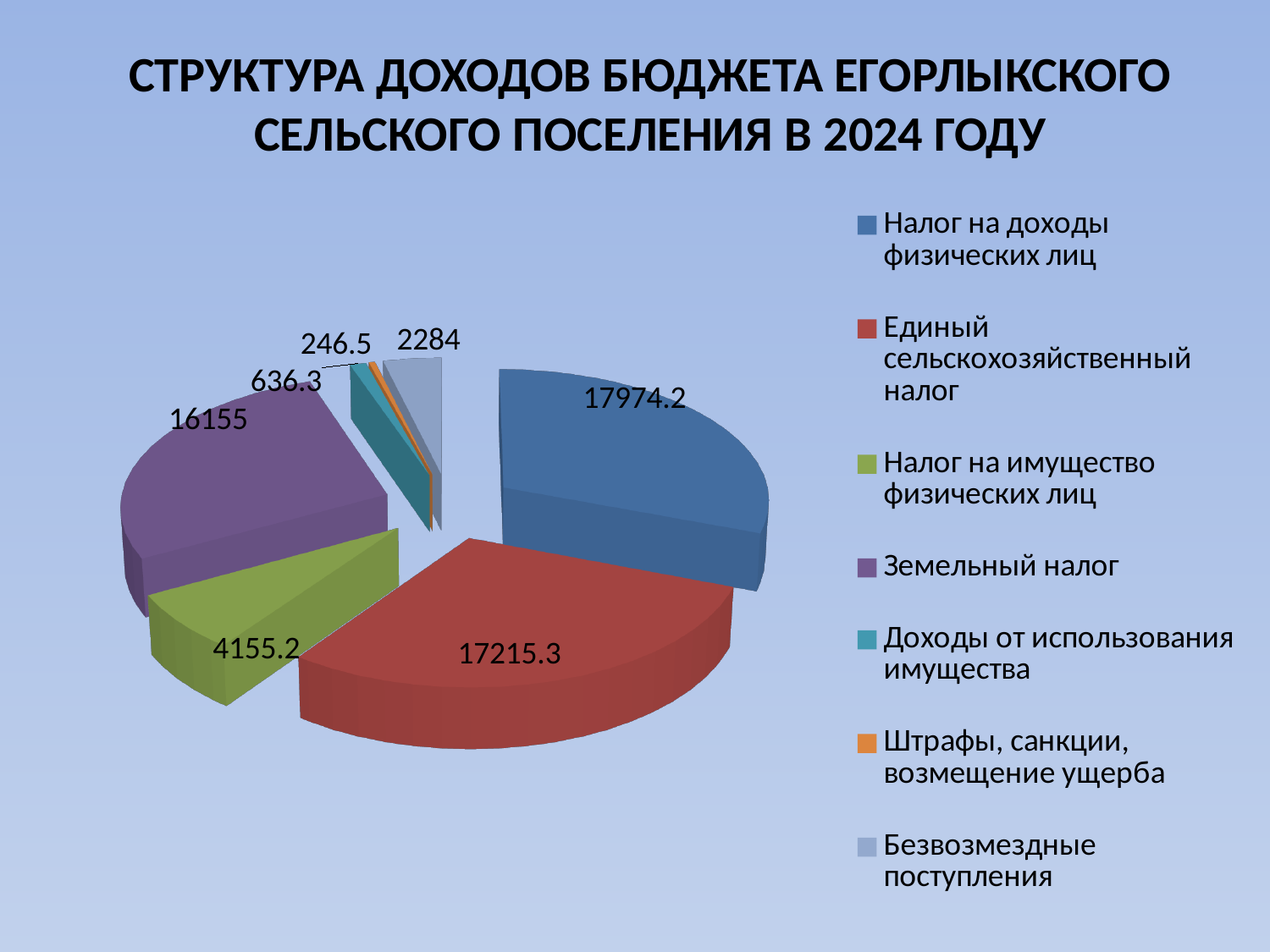
Which category has the smallest value? Штрафы, санкции, возмещение ущерба Which category has the largest value? Налог на доходы физических лиц What is the title of the slide? СТРУКТУРА ДОХОДОВ БЮДЖЕТА ЕГОРЛЫКСКОГО СЕЛЬСКОГО ПОСЕЛЕНИЯ В 2024 ГОДУ What is the value for Безвозмездные поступления? 2284 Which is larger: Земельный налог or Налог на имущество физических лиц? Земельный налог What is the difference between the values for Налог на доходы физических лиц and Единый сельскохозяйственный налог? 758.9 What is the value for Единый сельскохозяйственный налог? 17215.3 What is the value for Налог на доходы физических лиц? 17974.2 What type of chart is shown on the slide? Pie chart How many slices does the pie chart have? 7 What is the value for Штрафы, санкции, возмещение ущерба? 246.5 What is the value for Земельный налог? 16155